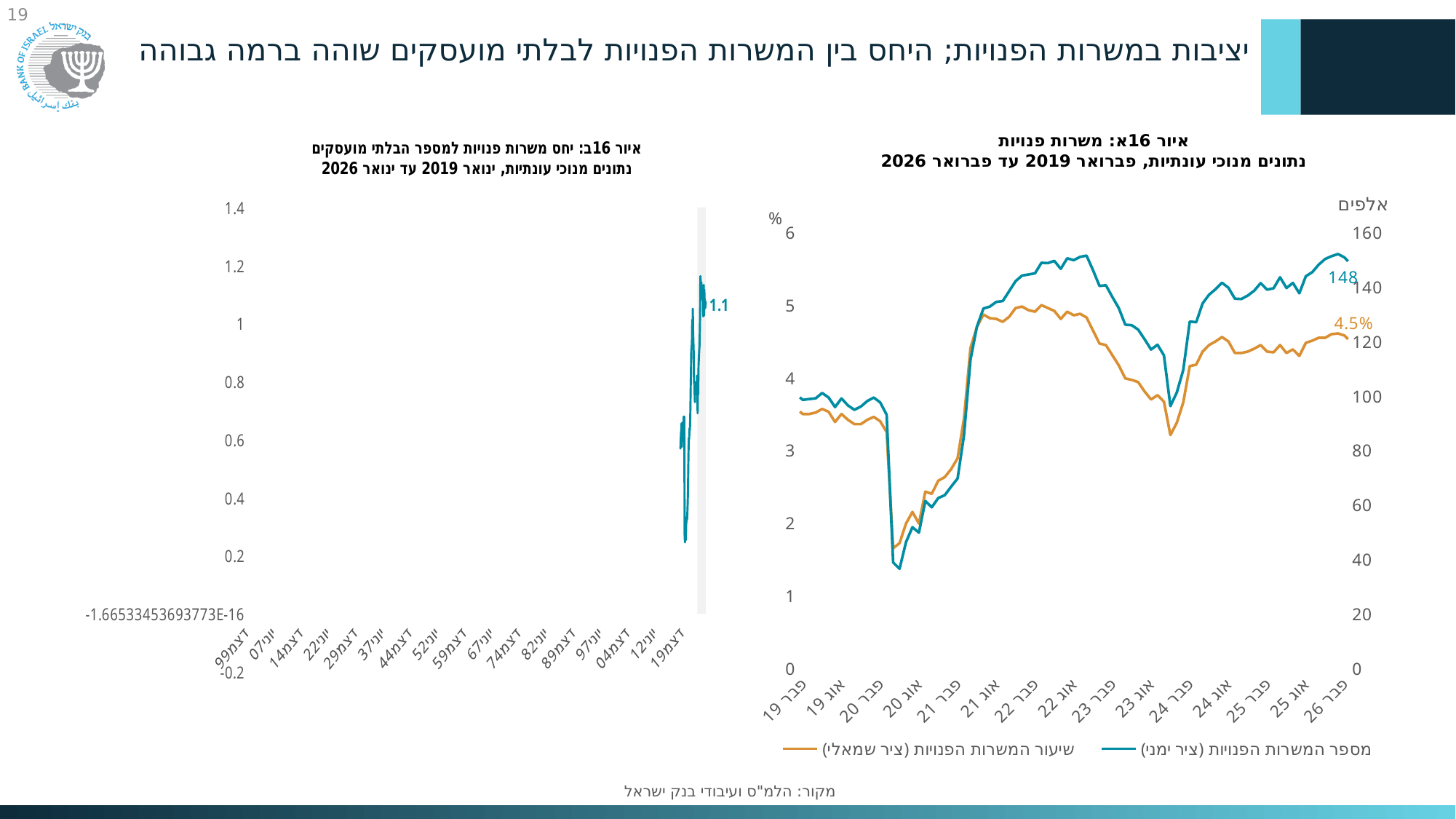
In the right-hand chart (איור 16א: משרות פנויות), what is the latest labelled value for the vacancy rate (שיעור המשרות הפנויות)? 4.5% In the right-hand chart (איור 16א), does the number of vacancies at the end of the period (פבר 26) sit higher or lower than at the start (פבר 19)? higher What unit label is shown above the right-hand axis of the right-hand chart (איור 16א)? אלפים What kind of chart is the right-hand chart (איור 16א: משרות פנויות)? line chart How many series does the legend of the right-hand chart (איור 16א) list? 2 What is the highest tick value shown on the vertical axis of the left-hand chart (איור 16ב)? 1.4 In the right-hand chart (איור 16א), is the number of vacancies at פבר 26 greater or less than 140 thousand? greater In the right-hand chart (איור 16א: משרות פנויות), what is the latest labelled value for the number of vacancies (מספר המשרות הפנויות)? 148 What kind of chart is the left-hand chart (איור 16ב)? line chart In the left-hand chart (איור 16ב), what is the labelled latest value of the ratio of vacancies to the number of unemployed? 1.1